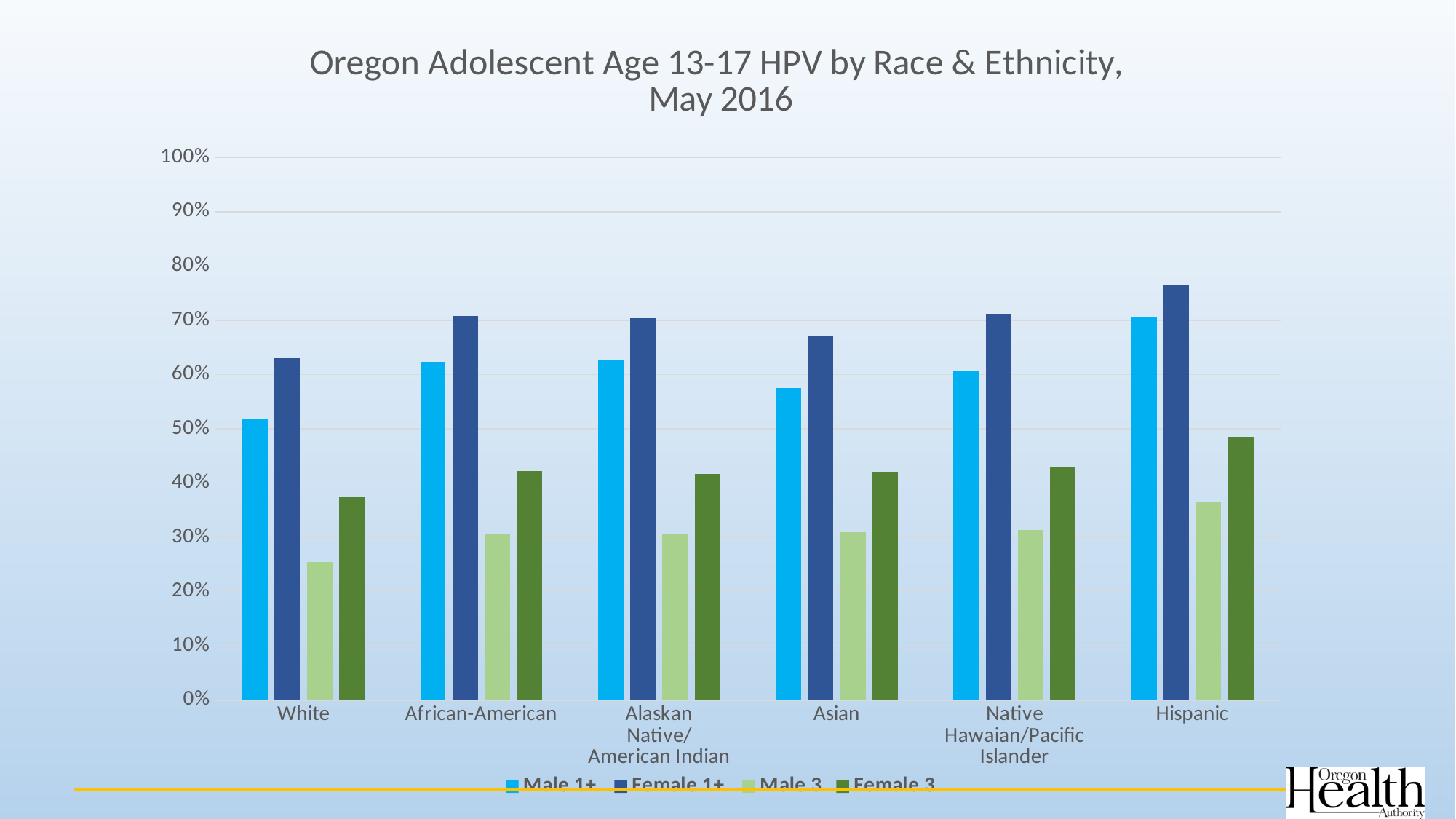
Which race/ethnicity category has the highest Female 1+ value? Hispanic Is the Male 1+ value for Asian greater or less than 60%? less How many series does the legend list? 4 How many race/ethnicity categories are shown on the x axis? 6 Which race/ethnicity category has the lowest Female 3 value? White What is the title of the chart? Oregon Adolescent Age 13-17 HPV by Race & Ethnicity, May 2016 What kind of chart is shown on the slide? Bar chart Is the Male 3 value for White greater or less than 30%? less Is the Female 1+ value for Hispanic greater or less than 70%? greater Which is larger: the Male 1+ value for African-American or the Male 1+ value for Asian? African-American Which race/ethnicity category has the highest Male 1+ value? Hispanic Which race/ethnicity category has the lowest Male 3 value? White